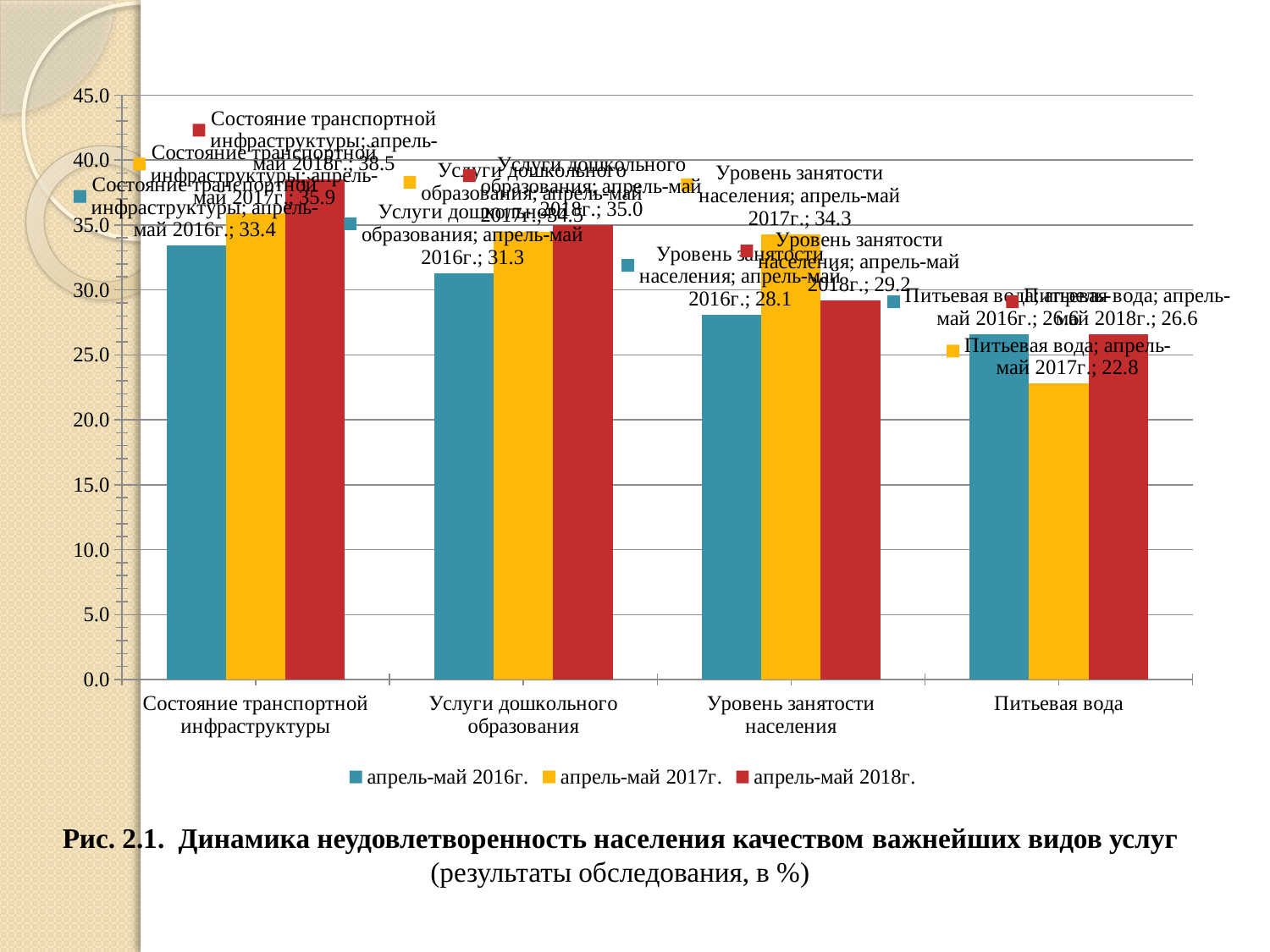
For Уровень занятости населения, which series has the larger value: апрель-май 2017г. or апрель-май 2018г.? апрель-май 2017г. Is the value for Питьевая вода in the апрель-май 2016г. series greater or less than 25.0? greater What is the value for Питьевая вода in the апрель-май 2017г. series? 22.8 By how much did the value for Состояние транспортной инфраструктуры increase from апрель-май 2016г. to апрель-май 2018г.? 5.1 What is the value for Состояние транспортной инфраструктуры in the апрель-май 2018г. series? 38.5 Which category has the lowest value in the апрель-май 2017г. series? Питьевая вода What is the value for Уровень занятости населения in the апрель-май 2017г. series? 34.3 How many series does the legend list? 3 What kind of chart is shown on the slide? bar chart What is the value for Состояние транспортной инфраструктуры in the апрель-май 2016г. series? 33.4 Which category has the highest value in the апрель-май 2018г. series? Состояние транспортной инфраструктуры What is the value for Услуги дошкольного образования in the апрель-май 2016г. series? 31.3